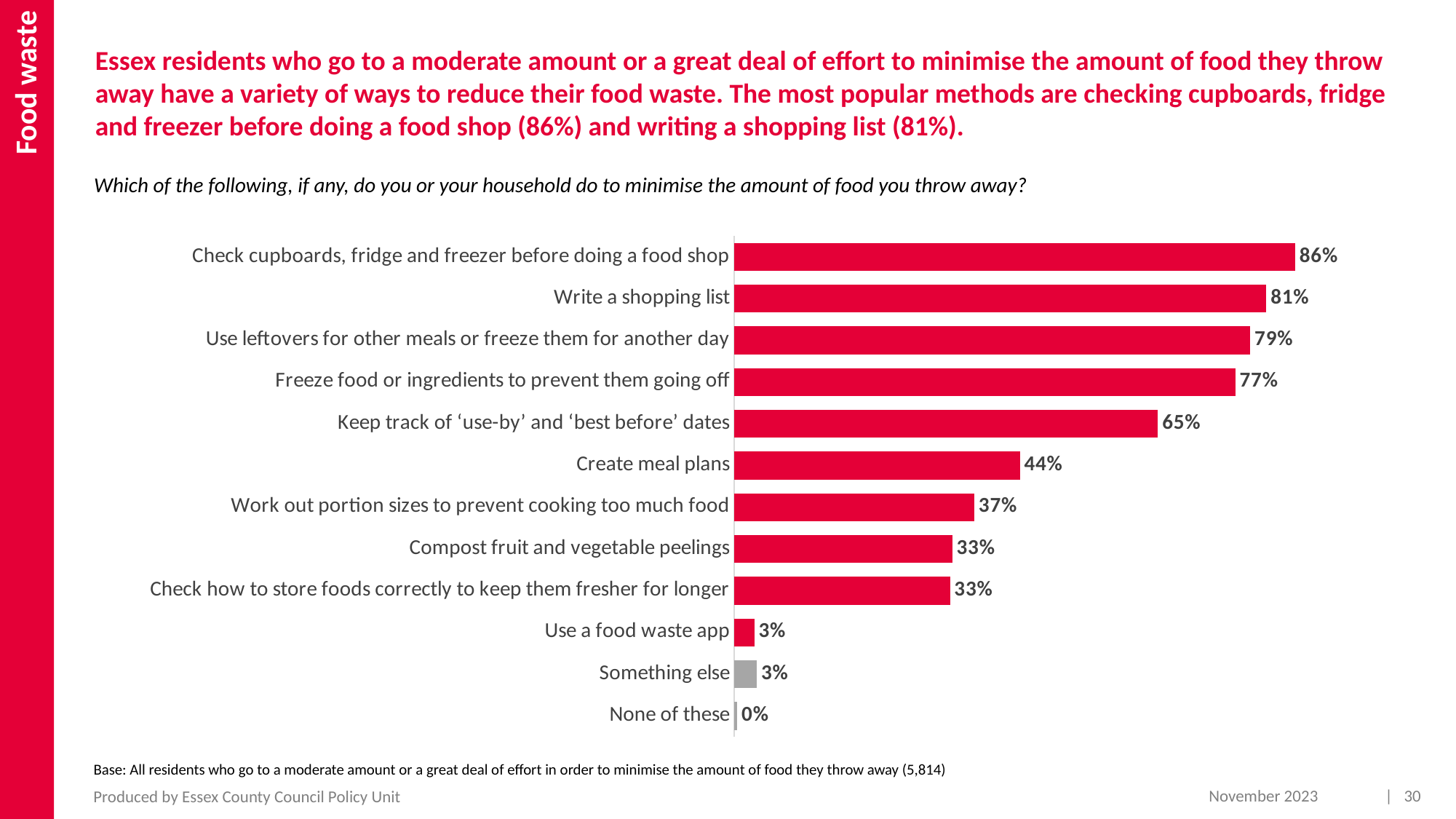
Which category has the lowest value? None of these What percentage of respondents use a food waste app? 3% What is the value for 'Create meal plans'? 44% How many categories are shown in the chart? 12 What kind of chart is shown on the slide? Bar chart Which bar is coloured grey rather than red? Something else Which category has the highest value? Check cupboards, fridge and freezer before doing a food shop What is the difference between 'Write a shopping list' and 'Create meal plans'? 37 percentage points Which is larger: 'Keep track of 'use-by' and 'best before' dates' or 'Work out portion sizes to prevent cooking too much food'? Keep track of 'use-by' and 'best before' dates What is the difference between 'Freeze food or ingredients to prevent them going off' and 'Compost fruit and vegetable peelings'? 44 percentage points What is the base size stated below the chart? 5,814 What percentage of respondents check cupboards, fridge and freezer before doing a food shop? 86%